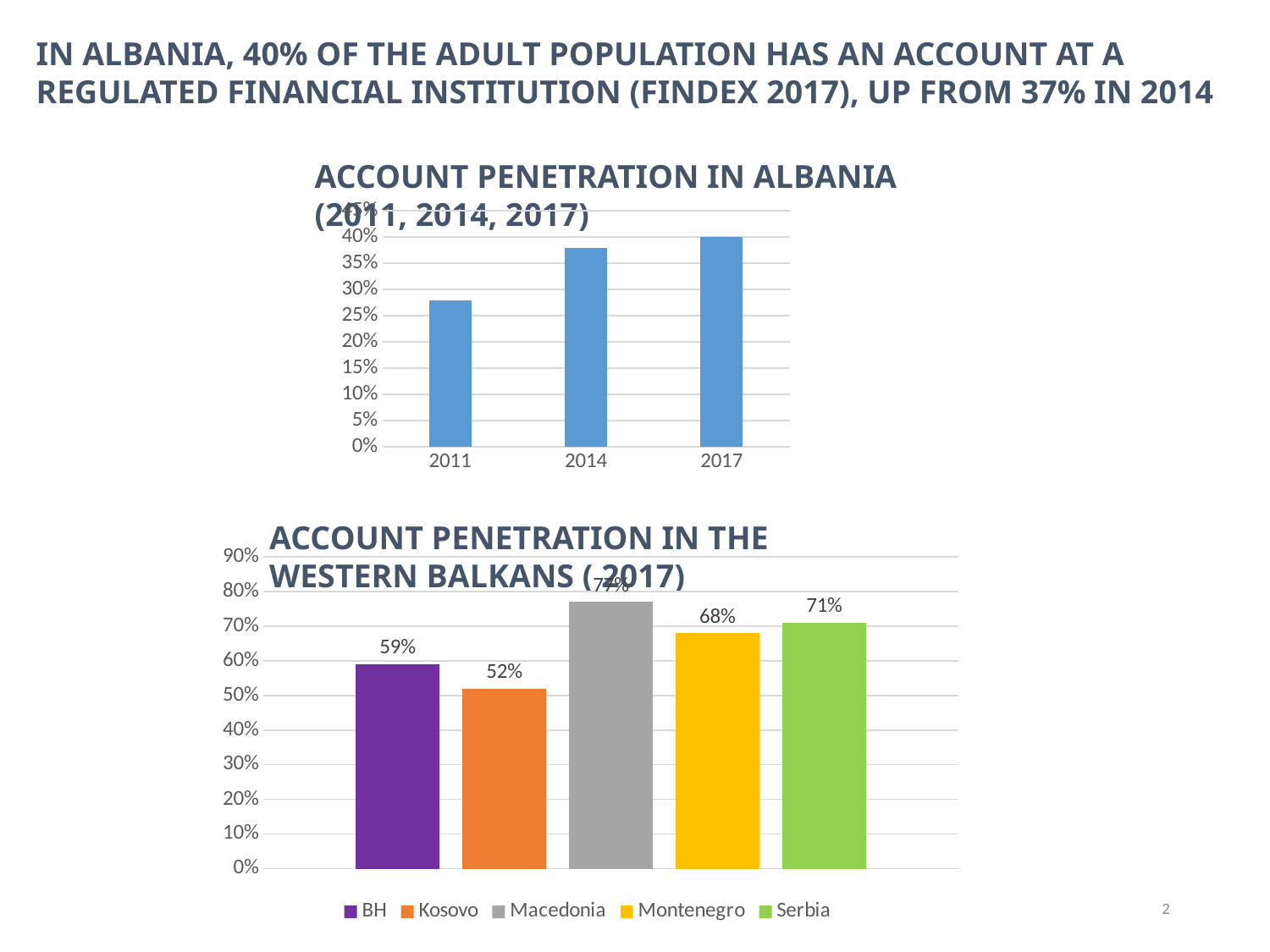
In the 'Account Penetration in Albania' chart, which is larger, the value for 2011 or the value for 2014? 2014 In the 'Account Penetration in the Western Balkans (2017)' chart, what is the value for BH? 59% In the 'Account Penetration in Albania' chart, how many years are plotted? 3 In the 'Account Penetration in the Western Balkans (2017)' chart, how many entries does the legend list? 5 In the 'Account Penetration in the Western Balkans (2017)' chart, what is the difference between the values for Serbia and Montenegro? 3% In the 'Account Penetration in Albania' chart, what is the value for 2017? 40% In the 'Account Penetration in Albania' chart, is the value for 2011 greater or less than 30%? less In the 'Account Penetration in Albania' chart, do the values rise or fall from 2011 to 2017? rise In the 'Account Penetration in the Western Balkans (2017)' chart, which country has the lowest value? Kosovo In the 'Account Penetration in Albania' chart, what kind of chart is shown? bar chart In the 'Account Penetration in the Western Balkans (2017)' chart, what is the value for Kosovo? 52% In the 'Account Penetration in the Western Balkans (2017)' chart, which country has the highest value? Macedonia